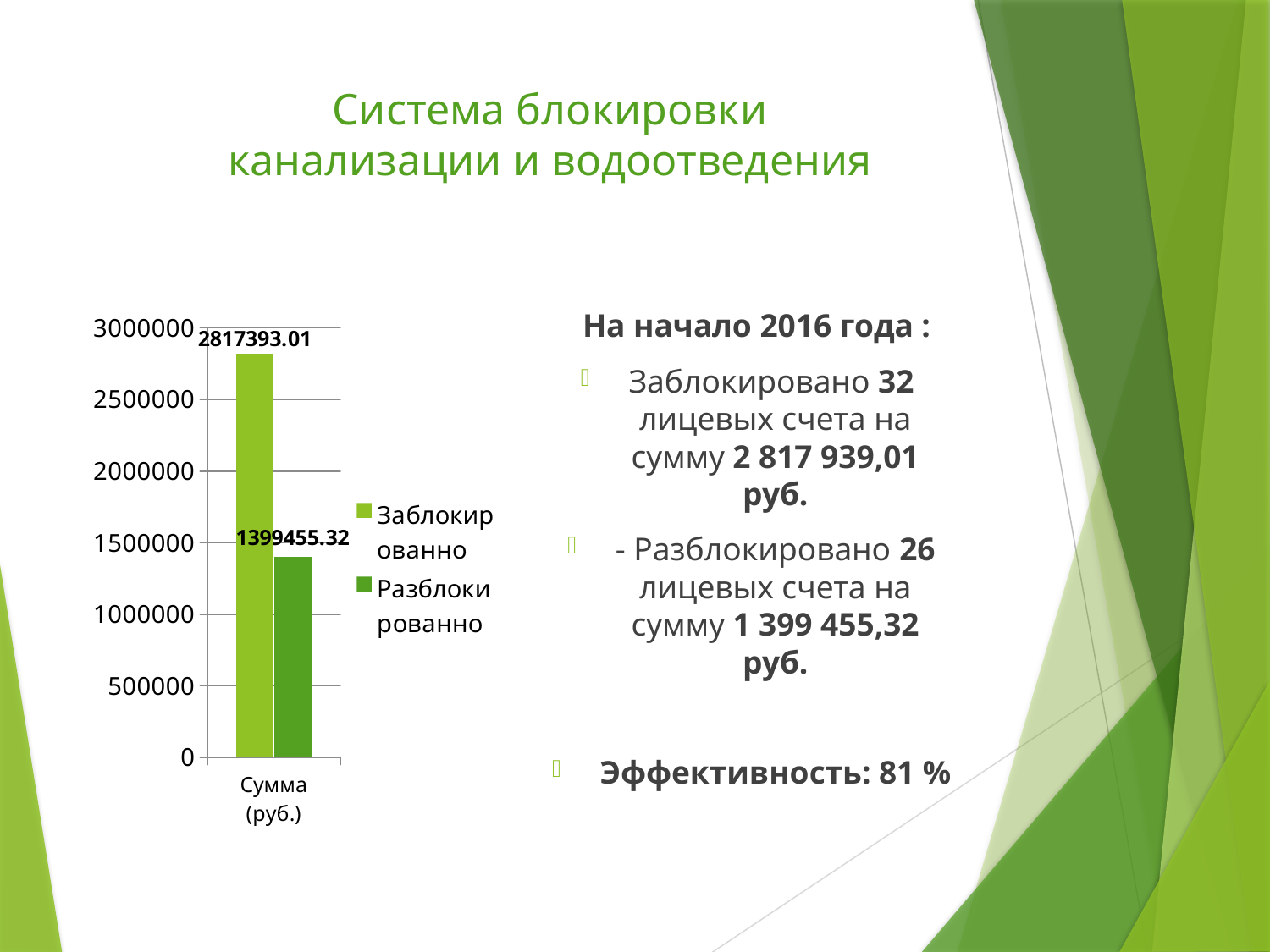
Which series has the higher value in the chart, Заблокированно or Разблокированно? Заблокированно How many series does the chart legend list? 2 What is the highest value shown on the y axis of the chart? 3000000 What is the label of the category on the x axis of the chart? Сумма (руб.) What is the value of the Разблокированно bar in the chart? 1399455.32 Which series has the lowest value in the chart? Разблокированно What is the difference between the Заблокированно and Разблокированно values in the chart? 1417937.69 Is the value for Разблокированно greater or less than 1500000? less Is the value for Заблокированно greater or less than 2500000? greater What is the value of the Заблокированно bar in the chart? 2817393.01 How many categories are shown on the x axis of the chart? 1 What kind of chart is shown on the slide? Bar chart